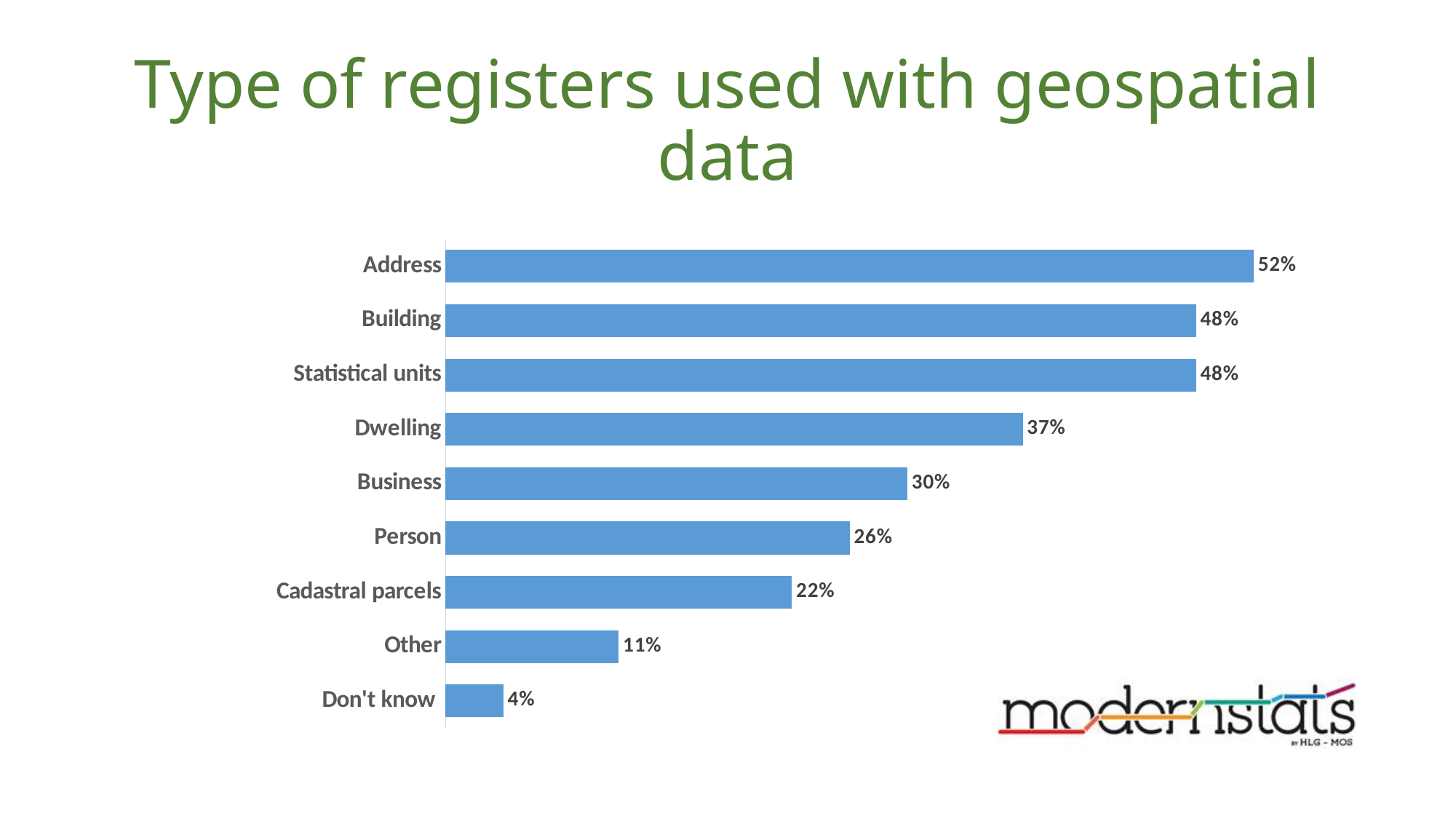
What percentage is shown for Address? 52% What is the title of the slide? Type of registers used with geospatial data What kind of chart is shown on the slide? Bar chart What percentage is shown for Cadastral parcels? 22% Which is larger, the value for Dwelling or the value for Business? Dwelling Which category has the lowest value? Don't know What is the value for Dwelling? 37% What is the difference between the values for Address and Building? 4% Which register type has the highest value? Address What is the difference between the values for Business and Person? 4% Which two categories share the same value of 48%? Building and Statistical units How many categories are shown in the chart? 9